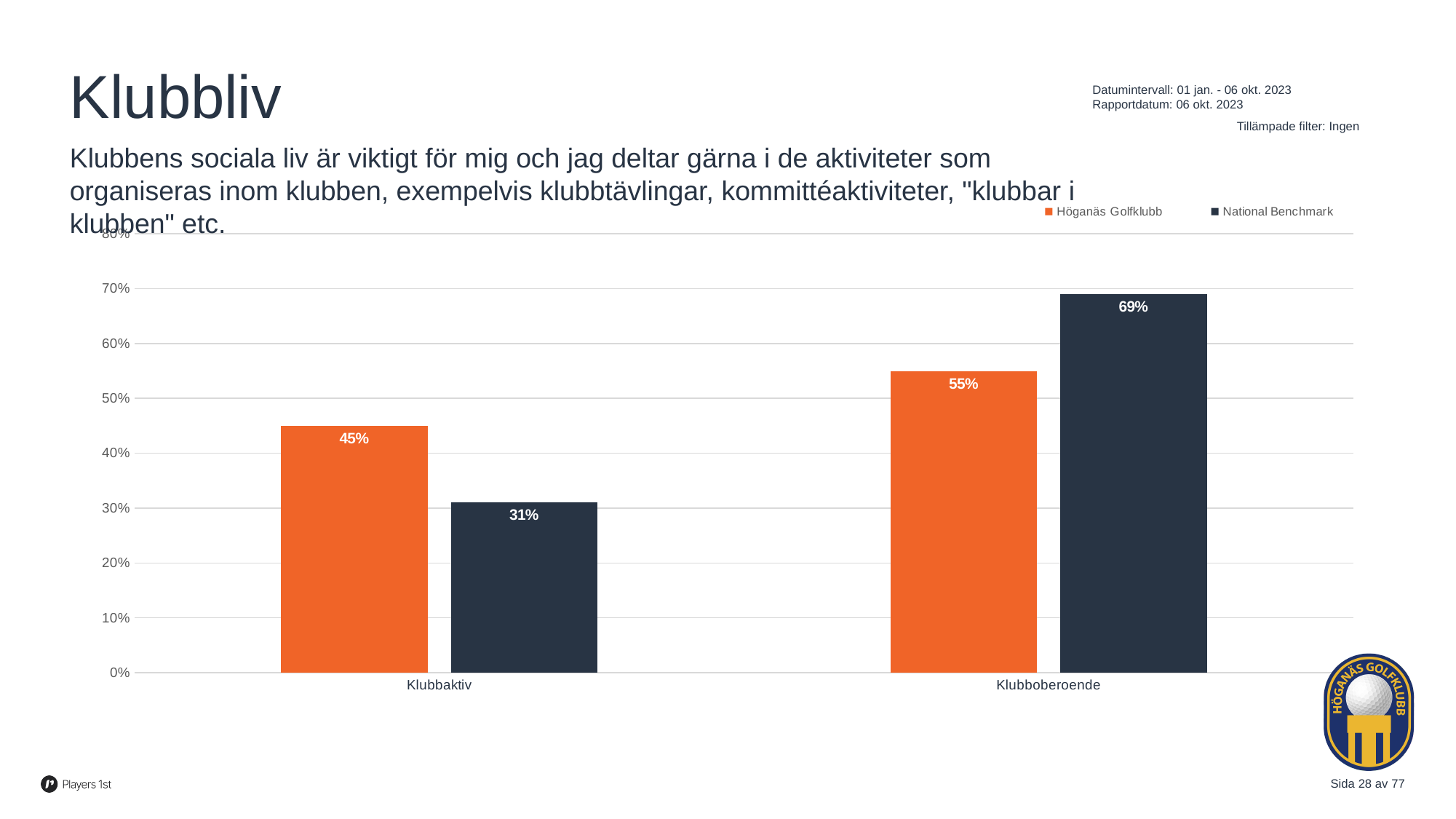
Which bar has the lowest value on the chart? National Benchmark, Klubbaktiv How many categories are shown on the x axis? 2 What is the value for Höganäs Golfklubb in the Klubboberoende category? 55% What is the value for Höganäs Golfklubb in the Klubbaktiv category? 45% Which bar has the highest value on the chart? National Benchmark, Klubboberoende What is the value for National Benchmark in the Klubbaktiv category? 31% What is the value for National Benchmark in the Klubboberoende category? 69% What is the difference between Höganäs Golfklubb and National Benchmark in the Klubbaktiv category? 14% What kind of chart is shown on the slide? Bar chart What is the difference between National Benchmark and Höganäs Golfklubb in the Klubboberoende category? 14% In the Klubboberoende category, which is larger: Höganäs Golfklubb or National Benchmark? National Benchmark How many series does the legend list? 2